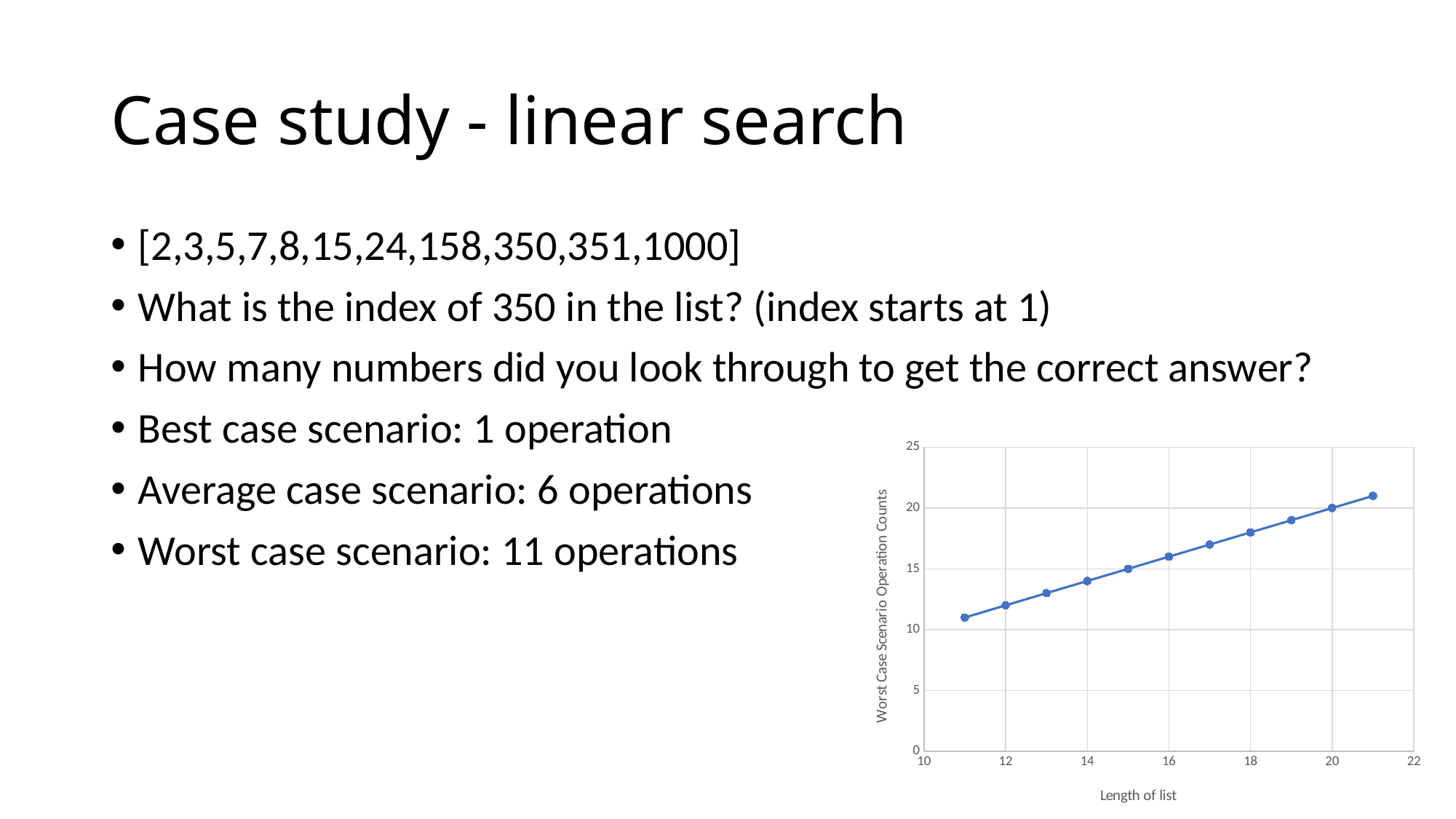
What is the worst case scenario operation count when the length of list is 20? 20 At which length of list is the worst case scenario operation count highest? 21 What type of chart is shown on the slide? line chart How many data points are plotted on the chart? 11 What is the label on the y axis of the chart? Worst Case Scenario Operation Counts At which length of list is the worst case scenario operation count lowest? 11 Which has a larger worst case scenario operation count: a list of length 16 or a list of length 12? length 16 What is the label on the x axis of the chart? Length of list Is the worst case scenario operation count for a list of length 14 greater or less than 15? less Is the worst case scenario operation count for a list of length 18 greater or less than 20? less Do the worst case scenario operation counts rise or fall as the length of list increases? rise Is the worst case scenario operation count for a list of length 12 greater or less than 10? greater